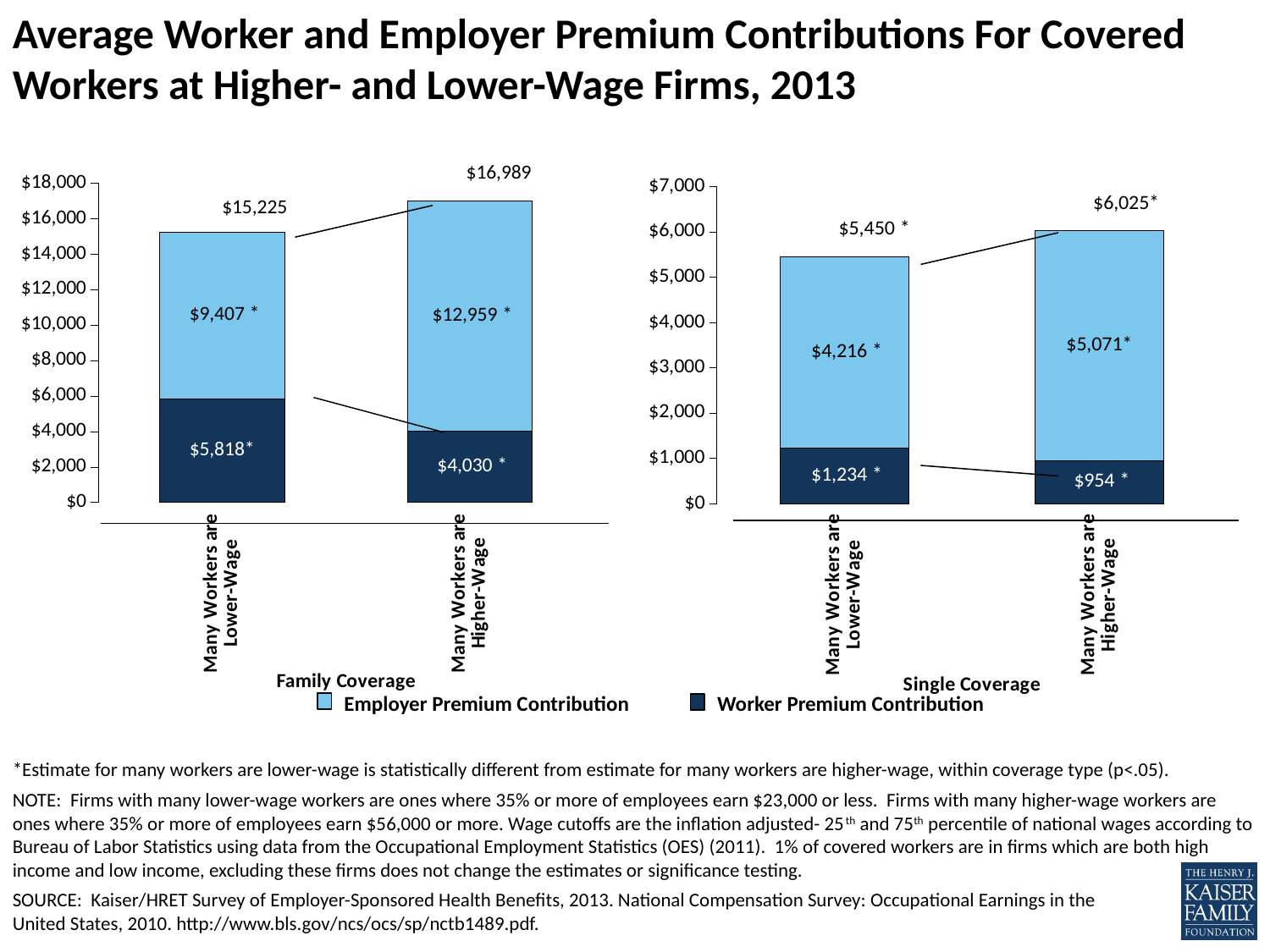
In the Single Coverage chart, which category has the larger Worker Premium Contribution, lower-wage firms or higher-wage firms? Many Workers are Lower-Wage In the Family Coverage chart, which category has the higher Employer Premium Contribution? Many Workers are Higher-Wage In the Single Coverage chart, what is the difference between the Employer Premium Contribution at higher-wage firms and at lower-wage firms? $855 What kind of chart is the Single Coverage chart? Stacked bar chart In the Single Coverage chart, what is the total premium for firms where many workers are lower-wage? $5,450 In the Single Coverage chart, what is the Worker Premium Contribution for firms where many workers are lower-wage? $1,234 In the Family Coverage chart, what is the Worker Premium Contribution for firms where many workers are higher-wage? $4,030 In the Single Coverage chart, what is the Employer Premium Contribution for firms where many workers are higher-wage? $5,071 In the Family Coverage chart, what is the difference between the Worker Premium Contribution at lower-wage firms and at higher-wage firms? $1,788 In the Family Coverage chart, what is the total premium for firms where many workers are higher-wage? $16,989 In the Family Coverage chart, what is the Employer Premium Contribution for firms where many workers are lower-wage? $9,407 How many series does the legend list? 2